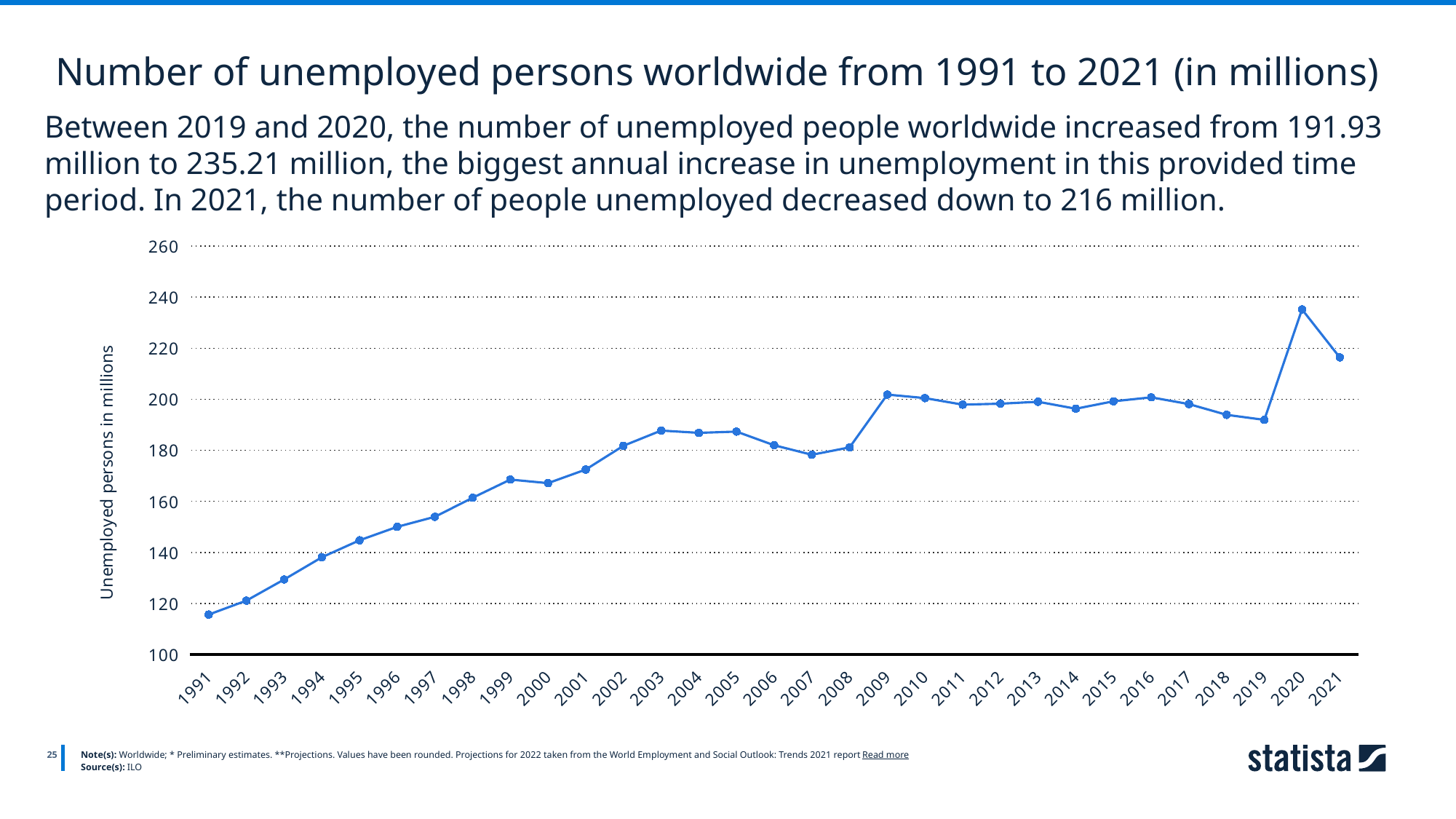
Is the value for 2020 greater or less than 220? greater Which year has the lowest number of unemployed persons worldwide? 1991 What kind of chart is shown on the slide? Line chart According to the slide, how many unemployed people were there worldwide in 2020? 235.21 million By how much did the number of unemployed persons worldwide increase between 2019 and 2020? 43.28 million How many years (data points) are plotted on the chart? 31 According to the slide, how many unemployed people were there worldwide in 2019? 191.93 million Which year has a higher value, 2020 or 2021? 2020 Is the value for 2003 greater or less than 200? less Is the value for 1991 greater or less than 120? less Which year has the highest number of unemployed persons worldwide? 2020 What is the label on the vertical axis of the chart? Unemployed persons in millions